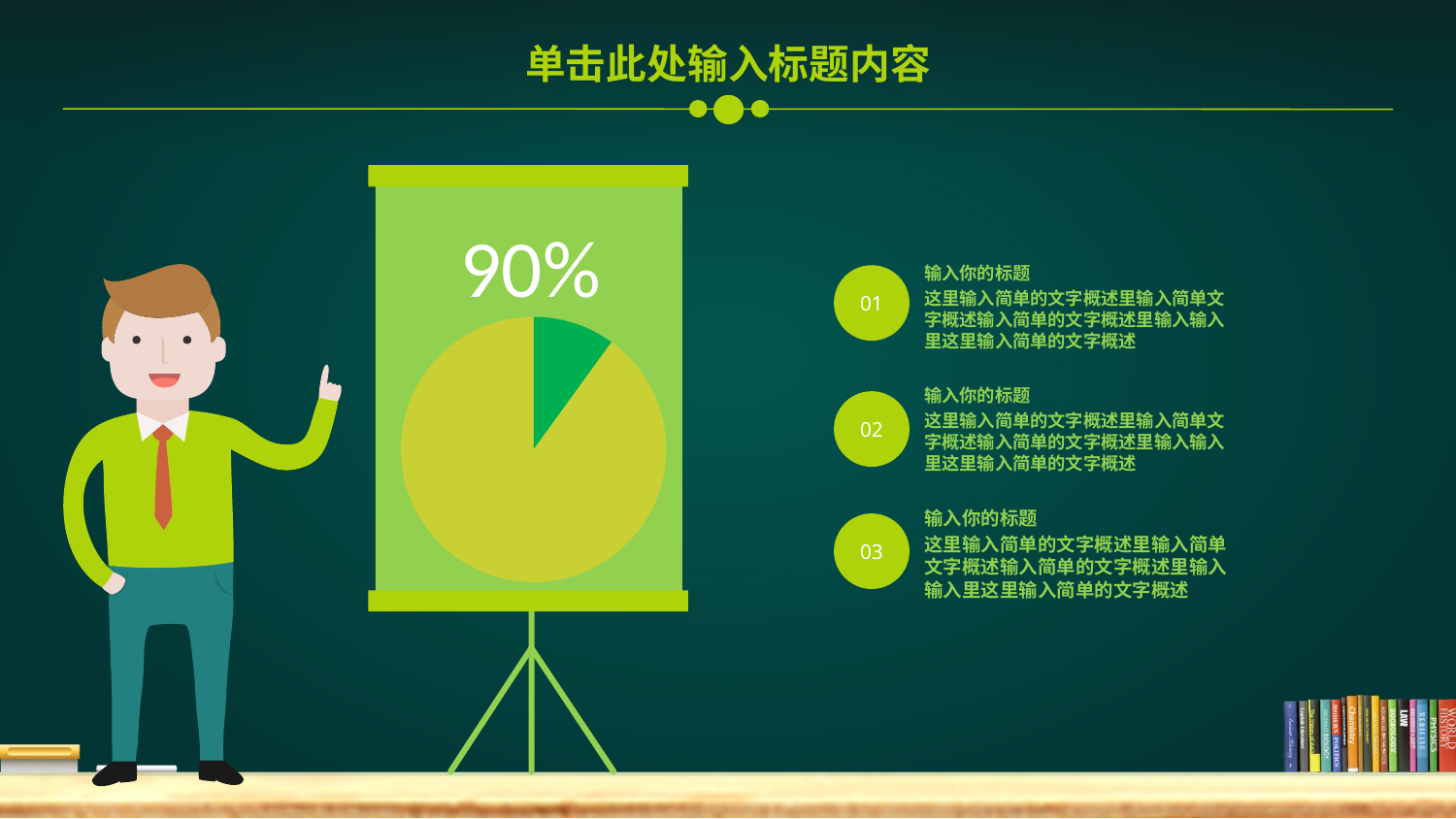
How many slices does the pie chart have? 2 What share of the pie does the large yellow-green slice represent, according to the printed label? 90% Which slice of the pie chart is larger, the yellow-green slice or the dark green slice? the yellow-green slice What colour is the smaller slice of the pie chart? dark green What kind of chart is shown on the slide? pie chart Is the share of the small dark green slice greater or less than 50%? less What percentage value is printed above the pie chart? 90% Does the pie chart have a legend? no